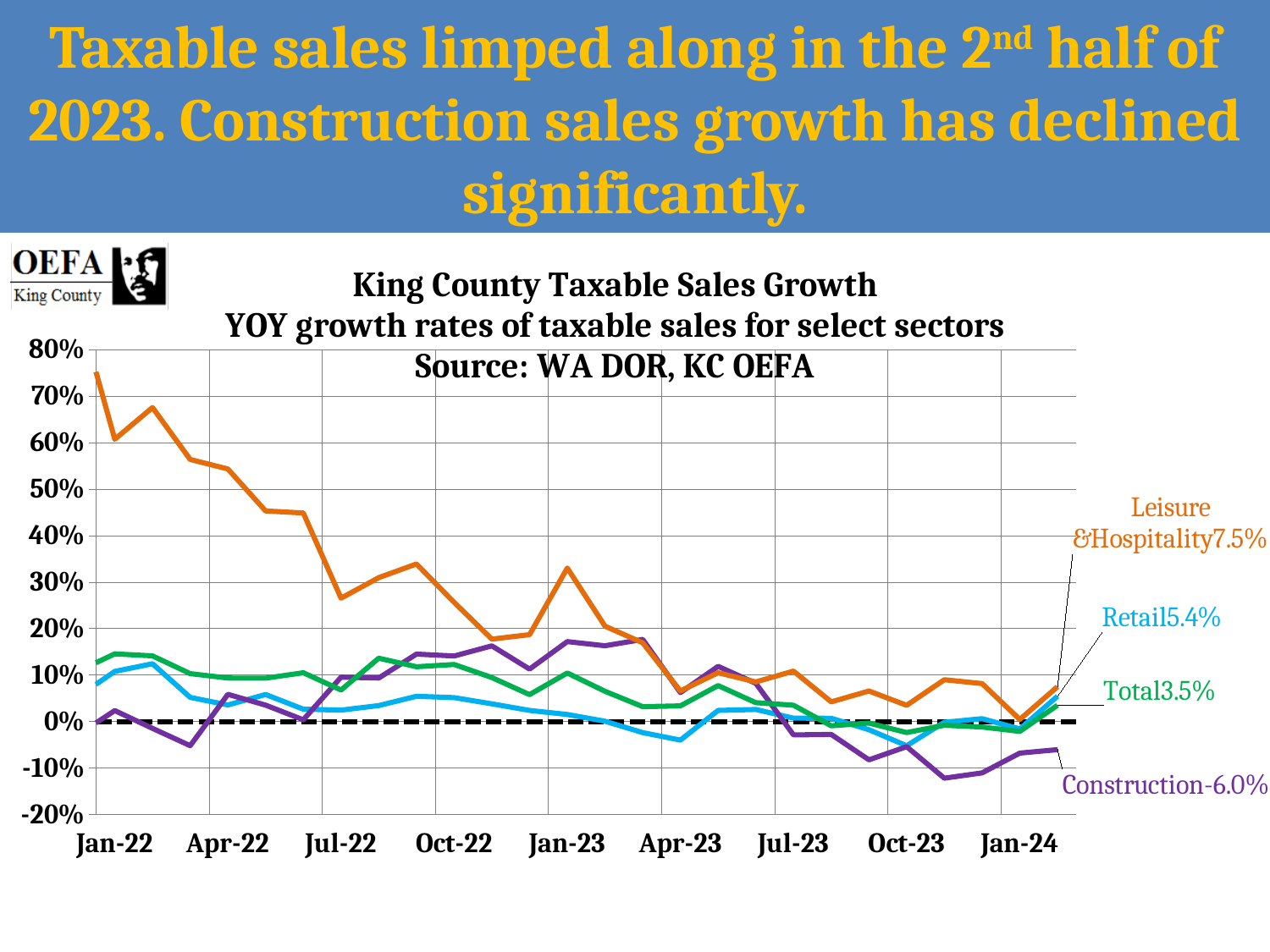
What is the final labelled value for Leisure & Hospitality? 7.5% Does the Leisure & Hospitality line generally rise or fall from Jan-22 to Jan-24? fall What is the difference between the final labelled values for Total and Construction? 9.5 percentage points Which series has the lowest final labelled value? Construction Is the value for Leisure & Hospitality at Jan-22 greater or less than 70%? less Which series has the highest final labelled value? Leisure & Hospitality What is the final labelled value for Total? 3.5% What kind of chart is shown on the slide? line chart What is the final labelled value for Retail? 5.4% How many data series are plotted in the King County Taxable Sales Growth chart? 4 Which has the larger final labelled value, Retail or Total? Retail What is the final labelled value for Construction? -6.0%